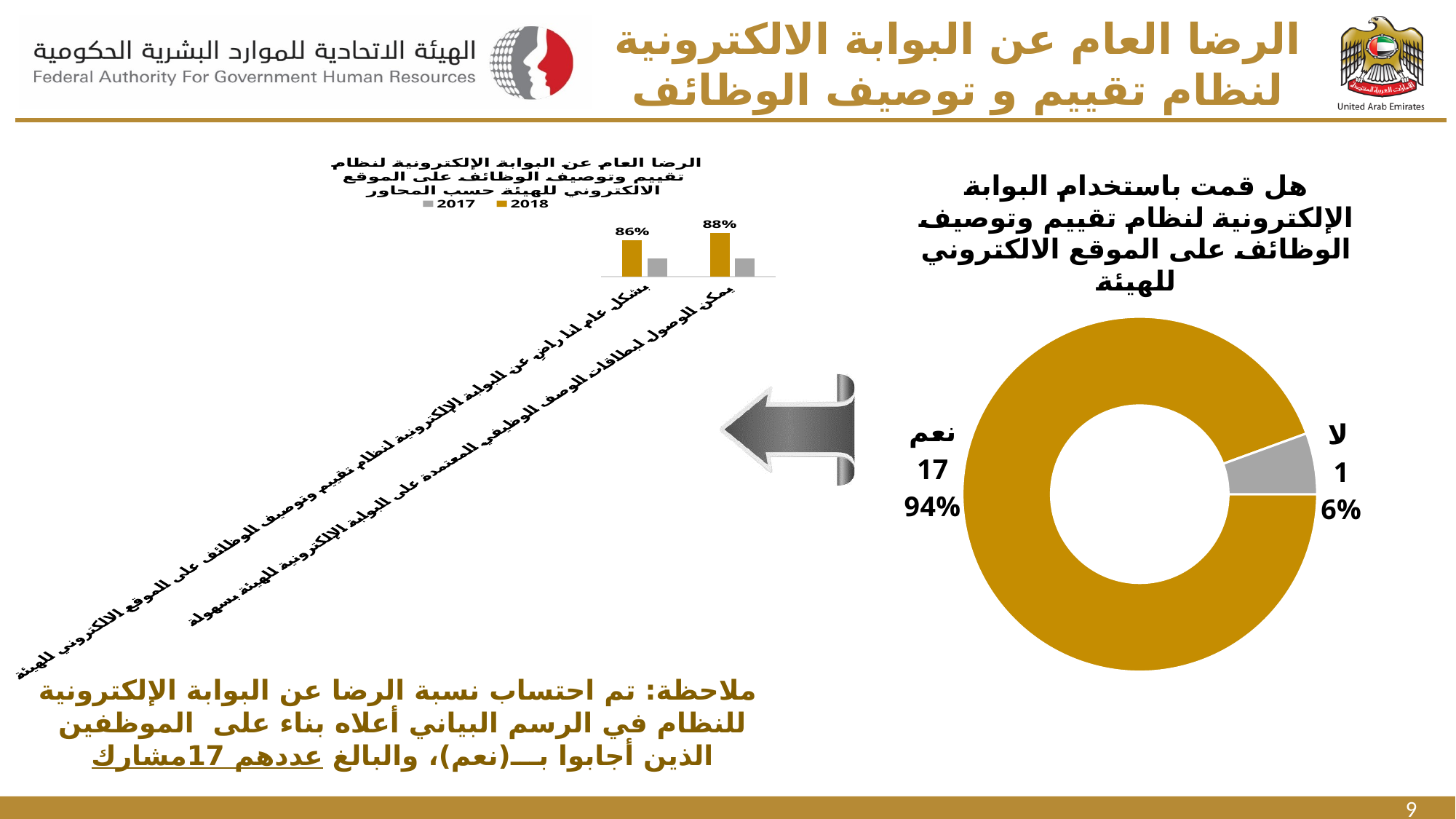
In the bar chart on the left, what is the 2018 value for the category 'يمكن الوصول لبطاقات الوصف الوظيفي المعتمدة على البوابة الإلكترونية للهيئة بسهولة'? 88% What kind of chart is the chart on the left of the slide? Bar chart In the donut chart on the right, what percentage share does نعم have? 94% In the donut chart on the right, which answer has the largest slice? نعم In the bar chart on the left, how many series does the legend list? 2 In the donut chart on the right, how many slices are there? 2 In the bar chart on the left, what is the difference between the two 2018 values? 2% In the donut chart on the right, how many respondents answered نعم? 17 In the donut chart on the right, what is the total number of respondents across both slices? 18 What kind of chart is the chart on the right of the slide? Donut (pie) chart In the bar chart on the left, what is the 2018 value for the category 'بشكل عام أنا راضٍ عن البوابة الإلكترونية لنظام تقييم وتوصيف الوظائف على الموقع الالكتروني للهيئة'? 86% In the donut chart on the right, what percentage share does لا have? 6%